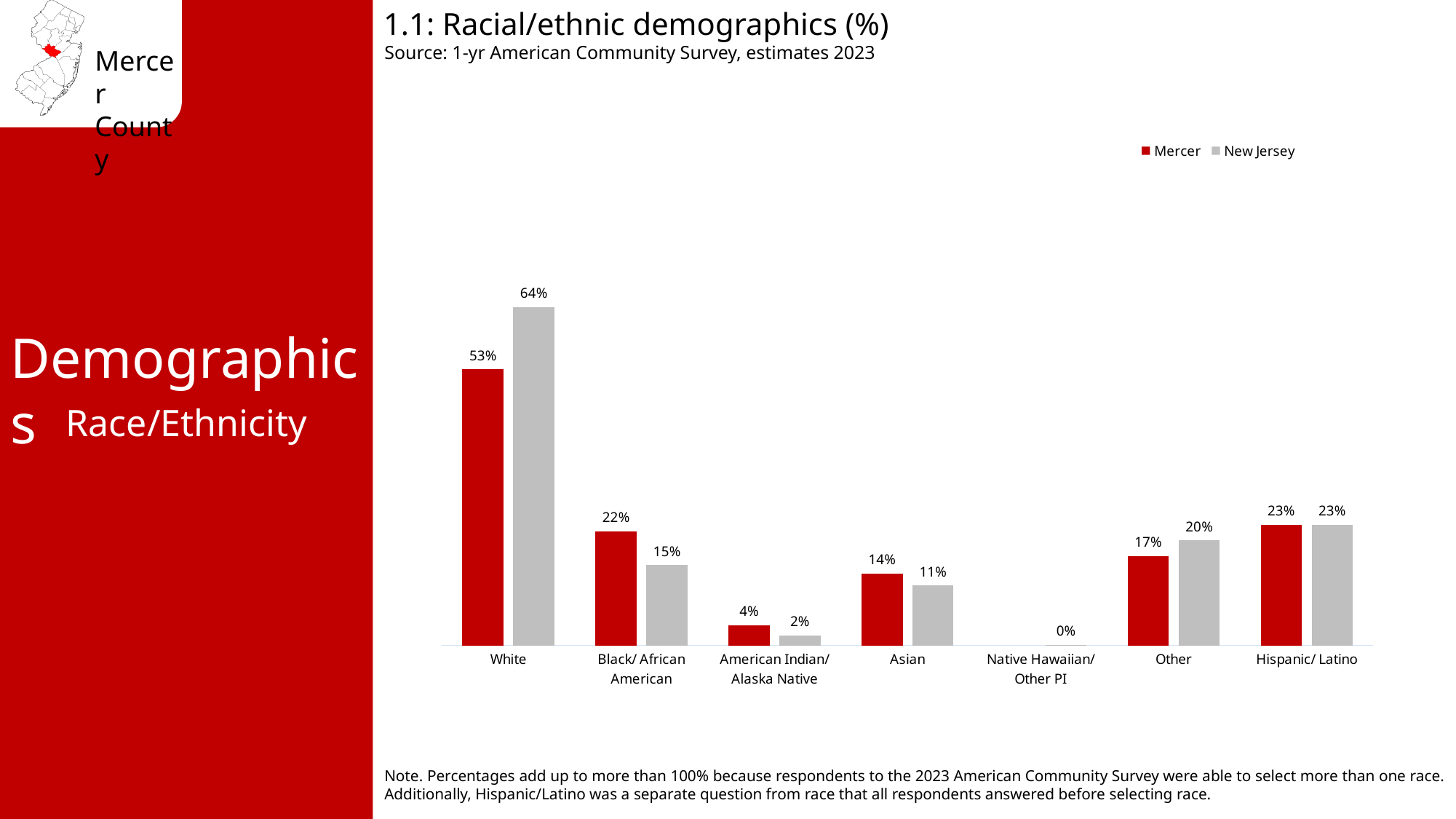
What is the New Jersey value for White? 64% How many series does the legend list? 2 What is the difference between the New Jersey and Mercer values for White? 11% What is the Mercer value for Black/ African American? 22% What is the New Jersey value for Other? 20% What kind of chart is shown on the slide? Bar chart How many categories are shown on the x axis? 7 What is the New Jersey value for Native Hawaiian/ Other PI? 0% What is the difference between the Mercer and New Jersey values for Black/ African American? 7% Which is larger for Asian, the Mercer value or the New Jersey value? Mercer Which category has the highest Mercer value? White What is the Mercer value for White? 53%